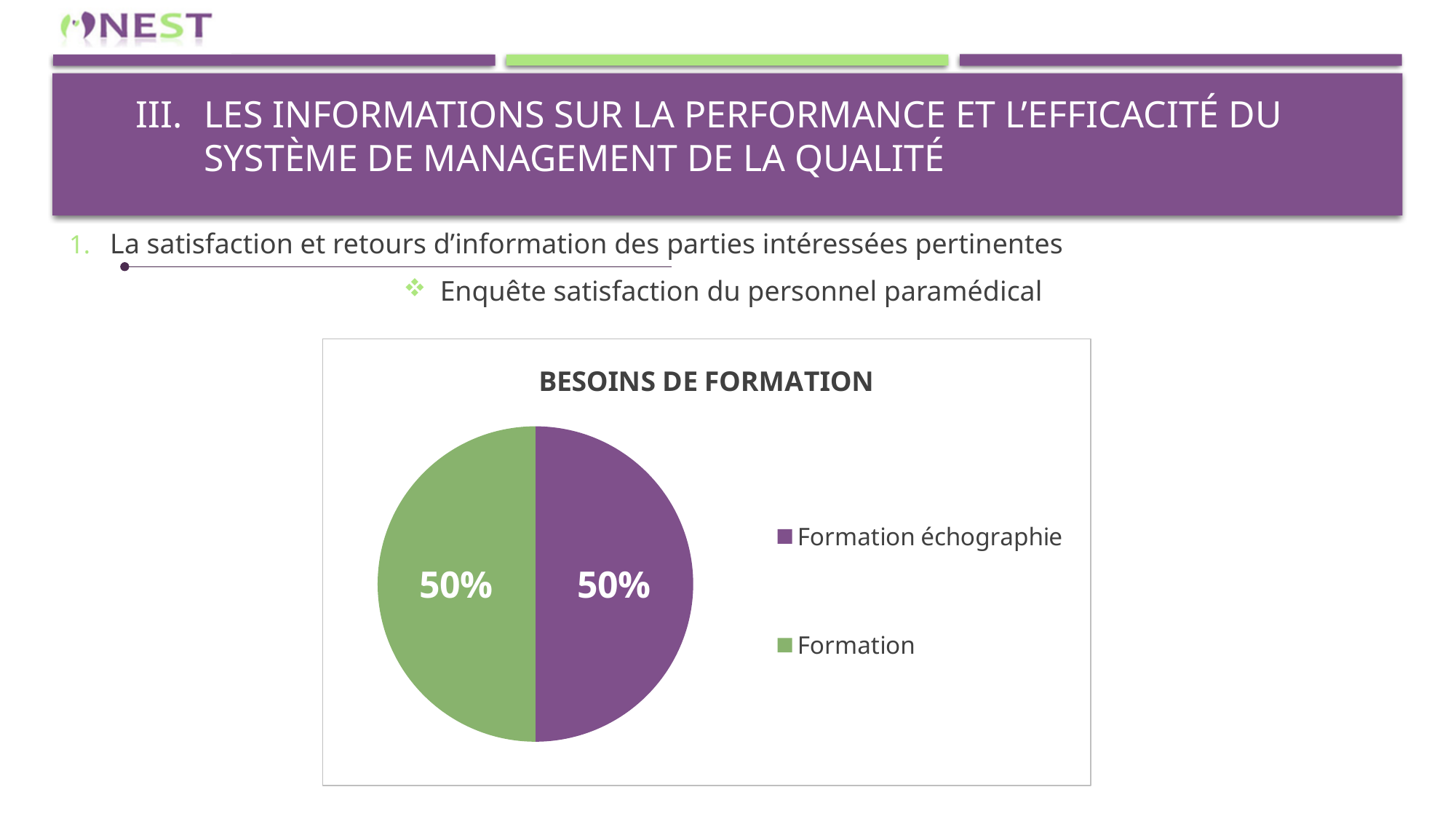
What is the total of the two slices shown in the pie chart? 100% What is the title of the chart? BESOINS DE FORMATION Which colour represents "Formation échographie" in the pie chart? purple How many entries does the legend list? 2 What share of the pie does "Formation échographie" represent? 50% How many slices does the pie chart have? 2 What share of the pie does "Formation" represent? 50% Is the share for "Formation" greater or less than 25%? greater What is the difference between the share for "Formation échographie" and the share for "Formation"? 0% What kind of chart is shown on the slide? pie chart